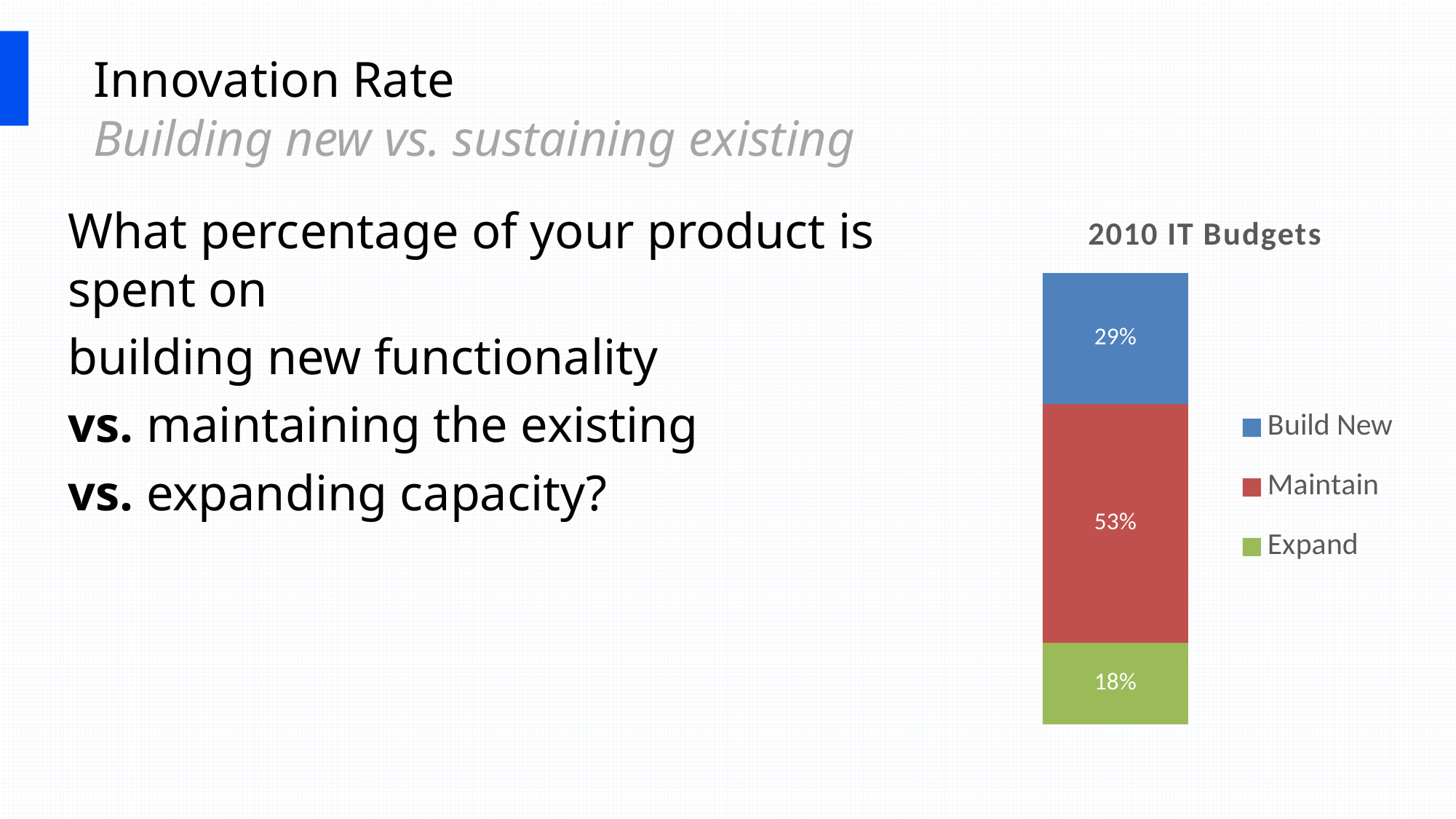
What is the difference between the Maintain and Build New values? 24% Which series has the lowest value in the 2010 IT Budgets chart? Expand Which series has the highest value in the 2010 IT Budgets chart? Maintain What is the title of the chart? 2010 IT Budgets What is the value for Expand in the 2010 IT Budgets chart? 18% What is the value for Maintain in the 2010 IT Budgets chart? 53% What is the difference between the Build New and Expand values? 11% What is the total of the stacked bar in the 2010 IT Budgets chart? 100% What is the value for Build New in the 2010 IT Budgets chart? 29% How many series does the legend list? 3 What kind of chart is shown on the slide? Stacked bar chart Which is larger, Build New or Expand? Build New